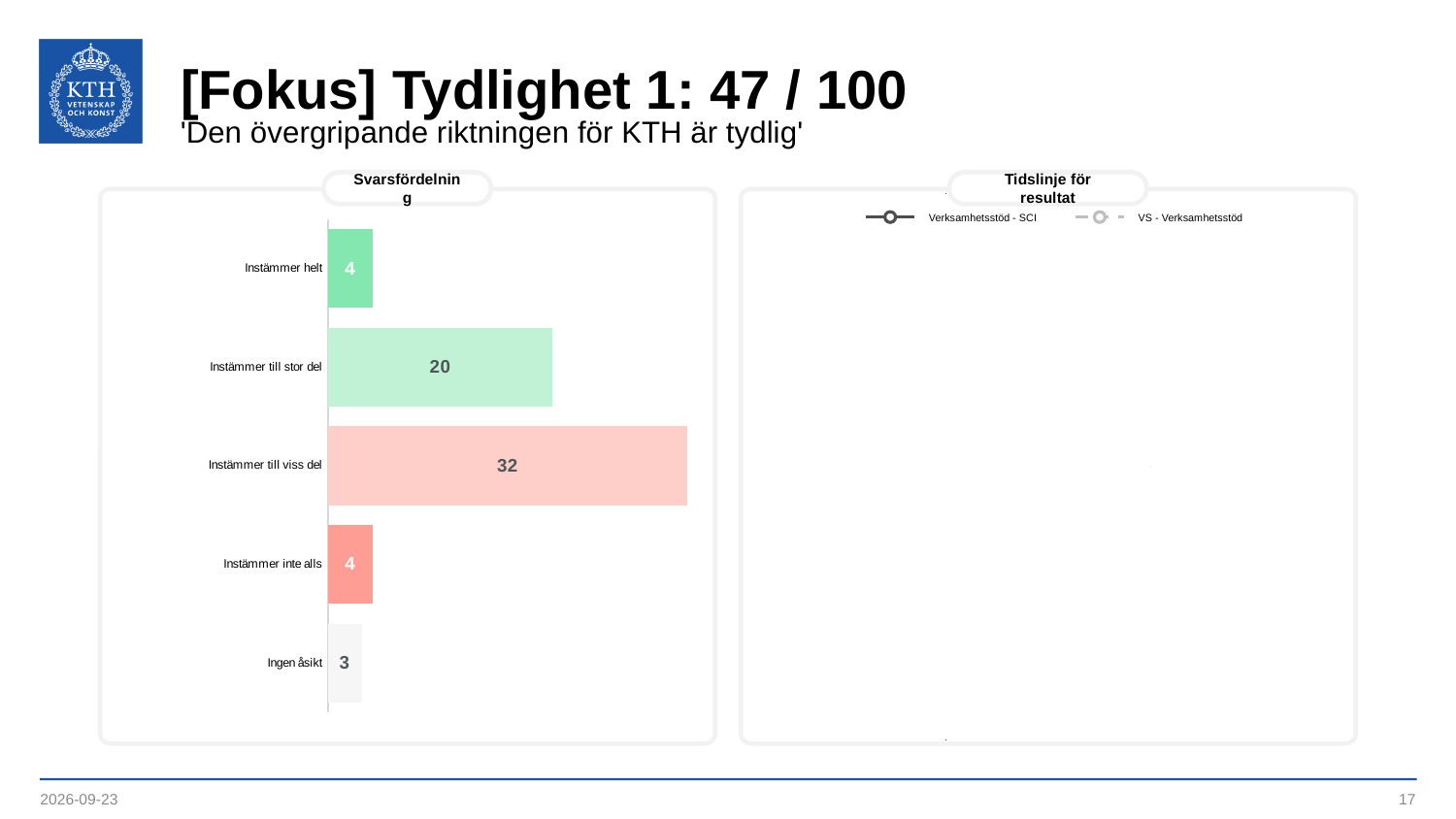
In the 'Svarsfördelning' chart, which category has the highest value? Instämmer till viss del How many categories are shown in the 'Svarsfördelning' chart? 5 In the 'Svarsfördelning' chart, what is the value for 'Ingen åsikt'? 3 In the 'Svarsfördelning' chart, which is larger: 'Instämmer till stor del' or 'Instämmer inte alls'? Instämmer till stor del In the 'Svarsfördelning' chart, what is the value for 'Instämmer till stor del'? 20 In the 'Svarsfördelning' chart, what is the value for 'Instämmer till viss del'? 32 In the 'Svarsfördelning' chart, which category has the lowest value? Ingen åsikt What is the first series named in the legend of the 'Tidslinje för resultat' chart? Verksamhetsstöd - SCI How many series does the legend of the 'Tidslinje för resultat' chart list? 2 In the 'Svarsfördelning' chart, what is the difference between 'Instämmer till viss del' and 'Instämmer till stor del'? 12 What kind of chart is the 'Svarsfördelning' chart? Bar chart In the 'Svarsfördelning' chart, what is the value for 'Instämmer helt'? 4